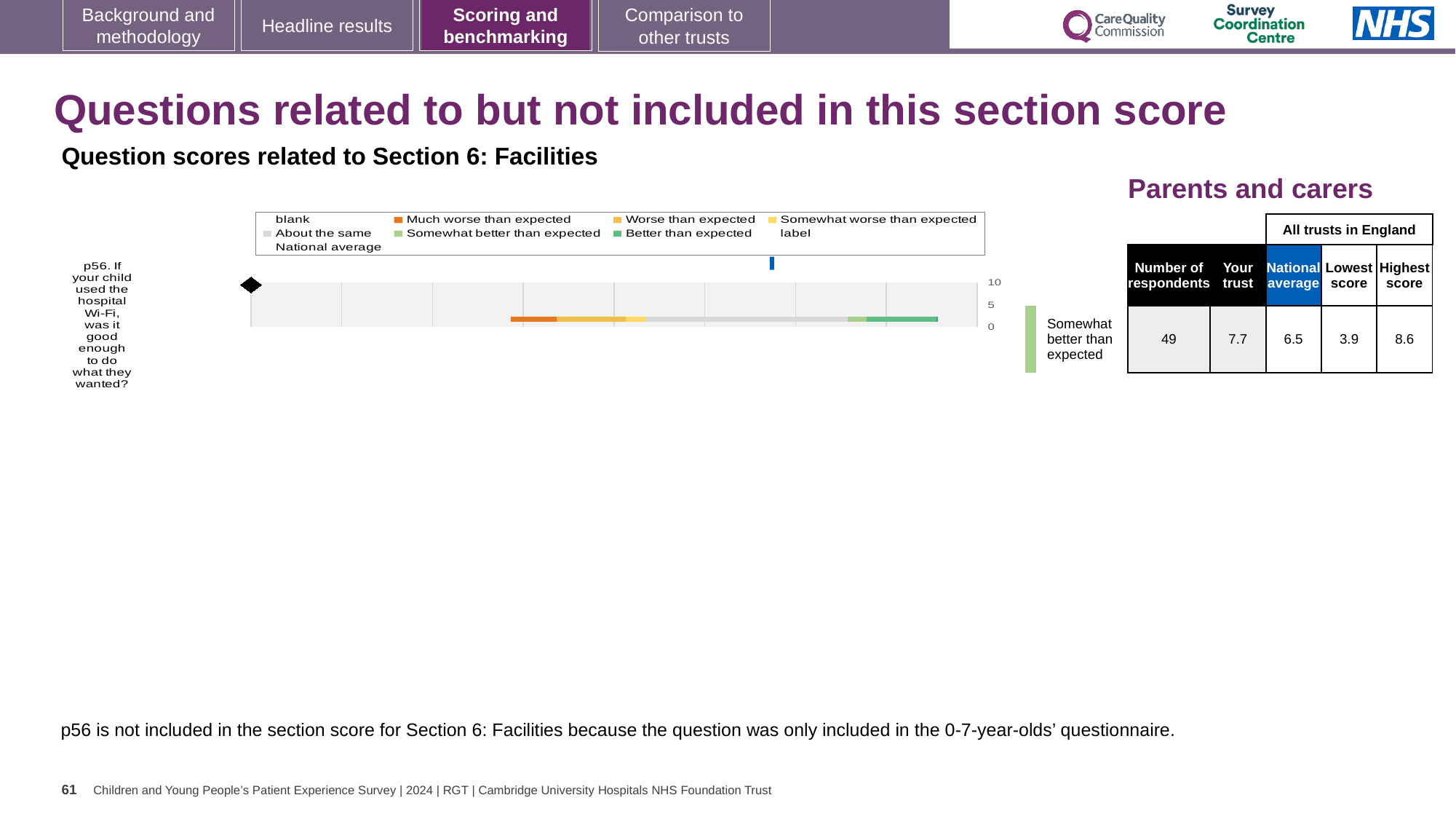
How many respondents answered p56? 49 What is the highest value shown on the chart's axis? 10 What is the highest score among all trusts in England for p56? 8.6 What is the difference between the 'Your trust' score and the national average for p56? 1.2 What is the national average score for p56? 6.5 Is the 'Your trust' score for p56 higher or lower than the national average? higher Which question is plotted in the chart? p56. If your child used the hospital Wi-Fi, was it good enough to do what they wanted? What is the 'Your trust' score for p56? 7.7 According to the label beside the chart, how does the trust's result for p56 compare to expected? Somewhat better than expected What is the lowest score among all trusts in England for p56? 3.9 What kind of chart is shown for question p56? bar chart How many questions (categories) are plotted in the chart? 1